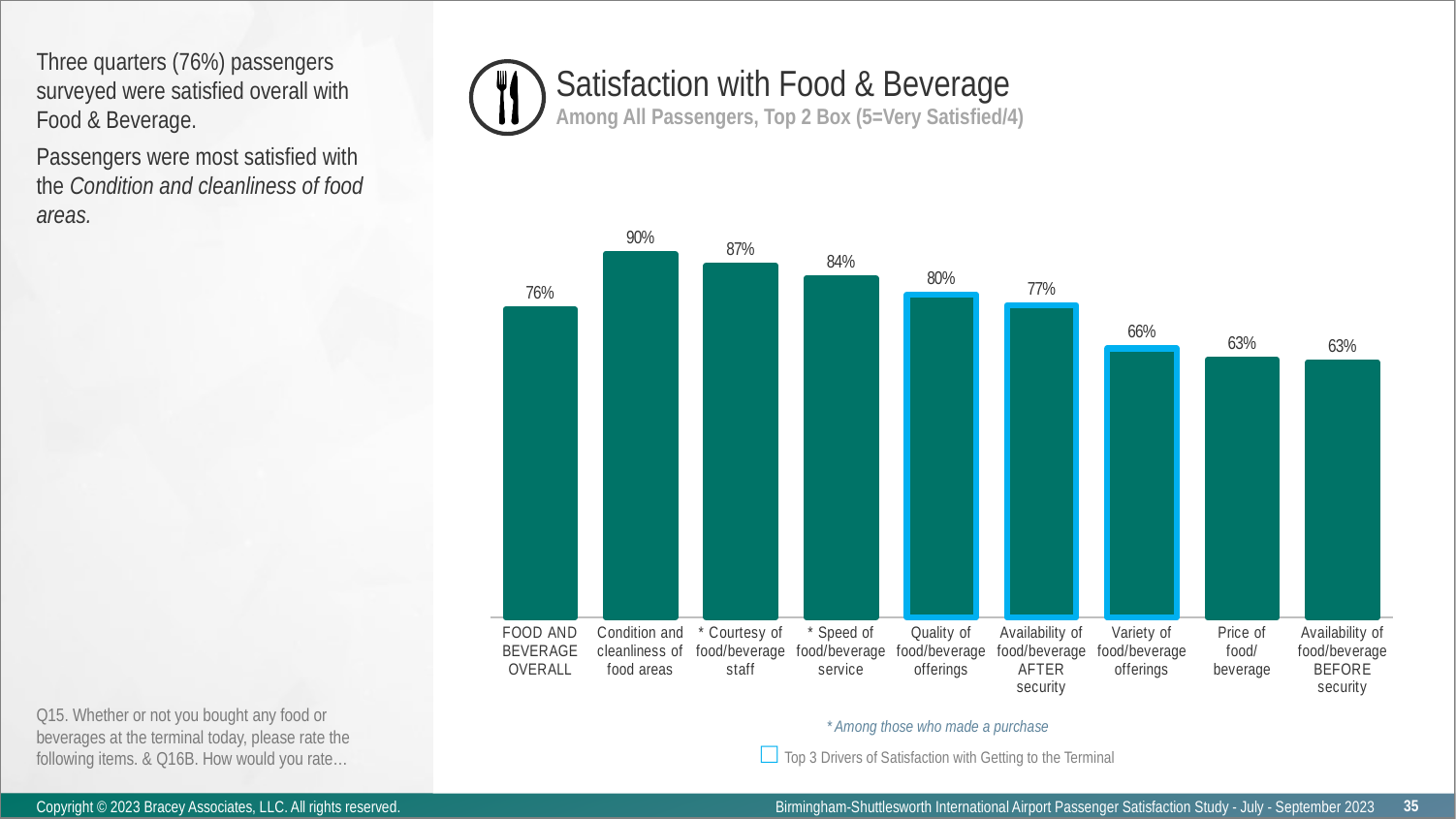
What is the value for FOOD AND BEVERAGE OVERALL? 76% How many bars are outlined in blue as Top 3 Drivers of Satisfaction? 3 What is the difference between Quality of food/beverage offerings and Variety of food/beverage offerings? 14% Which category has the highest value? Condition and cleanliness of food areas What is the value for Condition and cleanliness of food areas? 90% What is the title of the chart? Satisfaction with Food & Beverage What is the value for Availability of food/beverage AFTER security? 77% How many categories are shown in the chart? 9 What is the value for Price of food/beverage? 63% Which is larger, Courtesy of food/beverage staff or Speed of food/beverage service? Courtesy of food/beverage staff What kind of chart is this? Bar chart What is the difference between Condition and cleanliness of food areas and FOOD AND BEVERAGE OVERALL? 14%